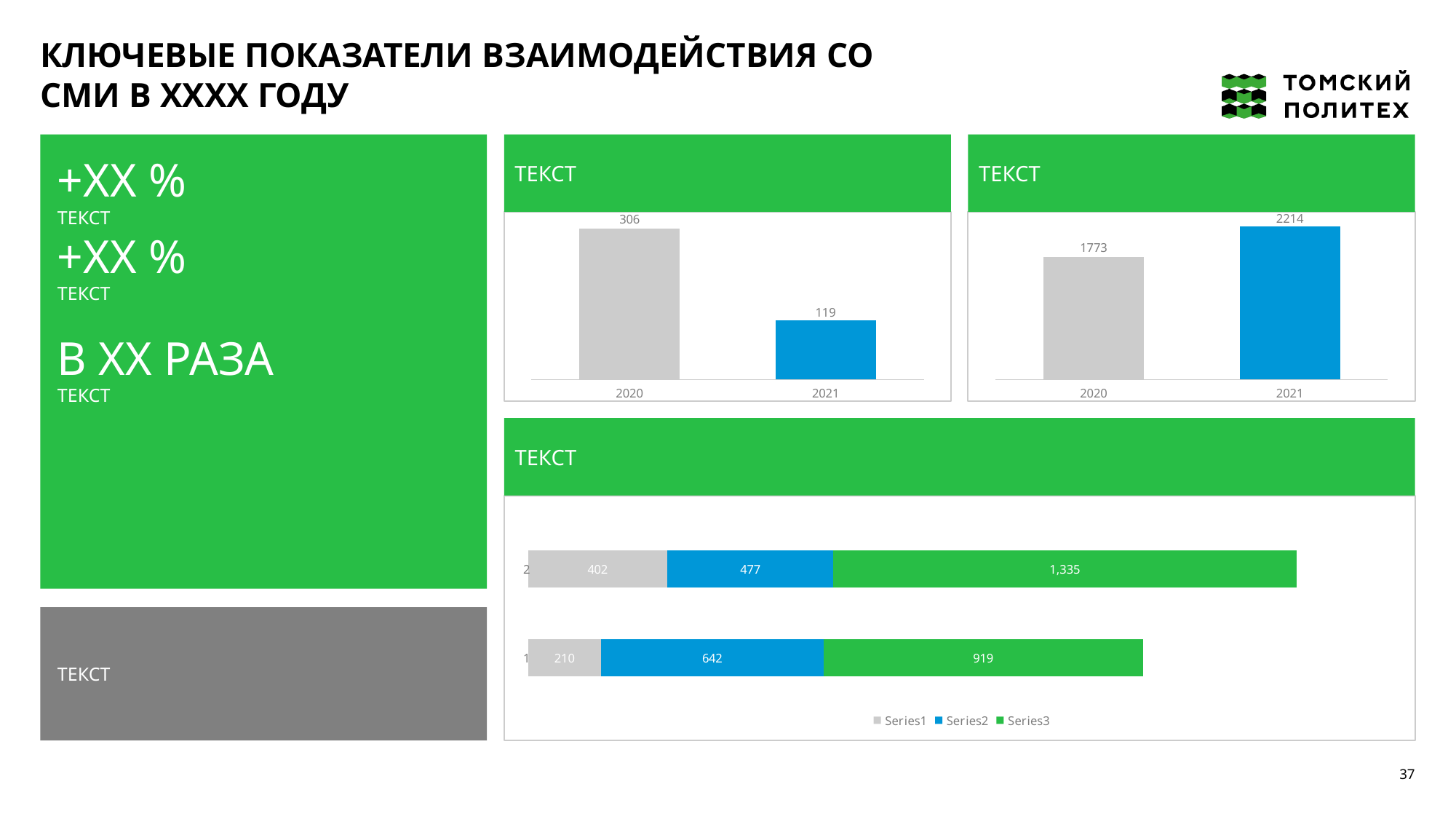
In the top-middle bar chart, what is the difference between the 2020 and 2021 values? 187 In the bottom stacked bar chart, what is the Series2 value for the bottom bar? 642 In the top-middle bar chart, do the values rise or fall from 2020 to 2021? fall What kind of chart is the chart at the bottom of the slide? stacked bar chart In the top-middle bar chart, what is the value for 2020? 306 In the top-right bar chart, which year has the higher value? 2021 In the bottom stacked bar chart, what is the total of the bottom bar? 1,771 In the top-right bar chart, what is the value for 2021? 2214 In the bottom stacked bar chart, how many series does the legend list? 3 In the top-right bar chart, what is the difference between the 2021 and 2020 values? 441 In the bottom stacked bar chart, what is the Series3 value for the top bar? 1,335 In the top-middle bar chart, what is the value for 2021? 119